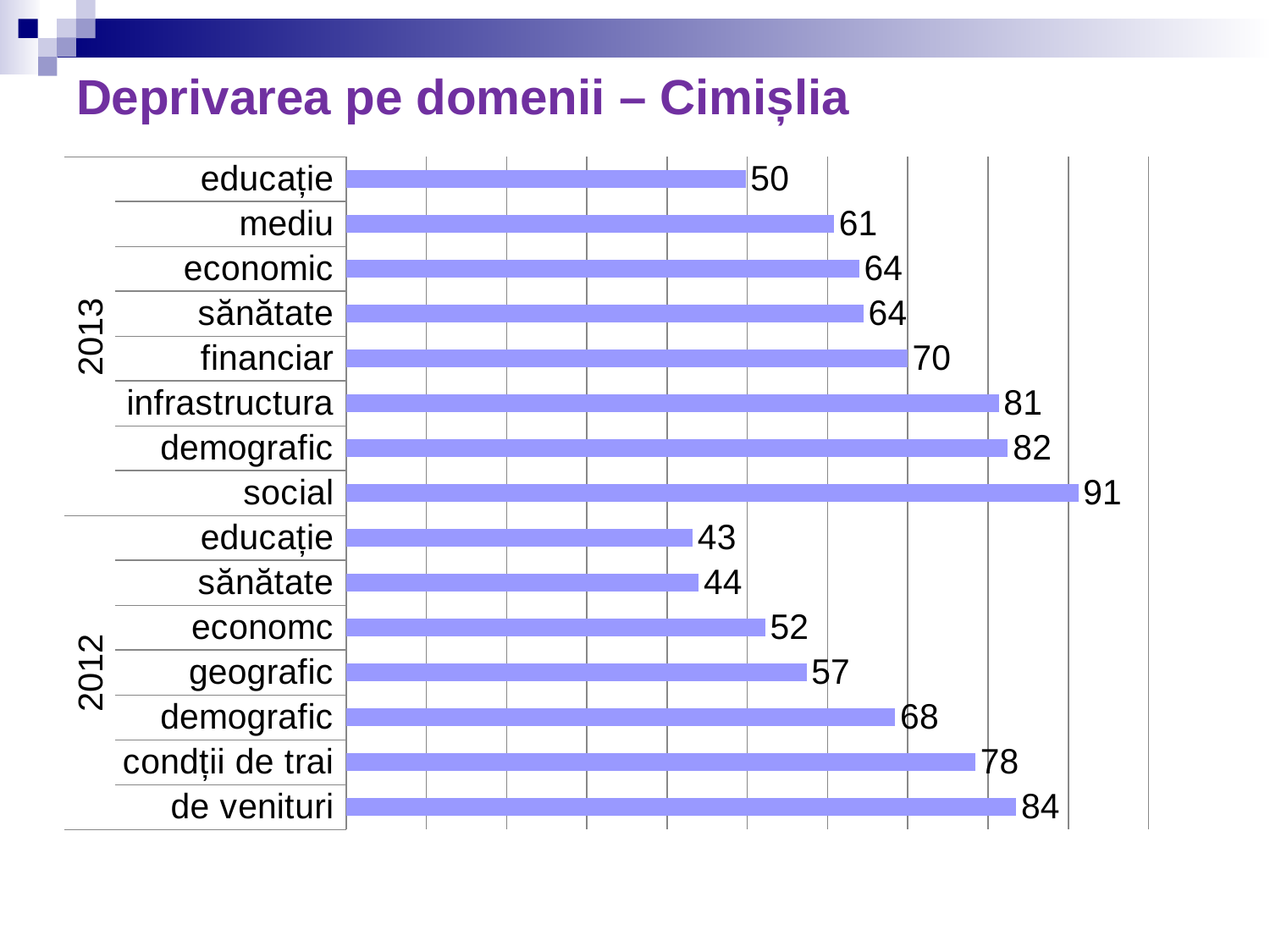
What is the difference between demografic in 2013 and demografic in 2012? 14 What is the difference between the value for educație in 2013 and educație in 2012? 7 What is the value for geografic in 2012? 57 Which category has the highest value in the 2013 group? social What is the value for financiar in 2013? 70 What is the value for social in 2013? 91 Which category has the lowest value in the 2012 group? educație What is the value for de venituri in 2012? 84 How many bars are plotted in the chart in total? 15 What kind of chart is shown on the slide? bar chart Which is larger: sănătate in 2013 or sănătate in 2012? sănătate in 2013 What is the title of the slide? Deprivarea pe domenii – Cimișlia